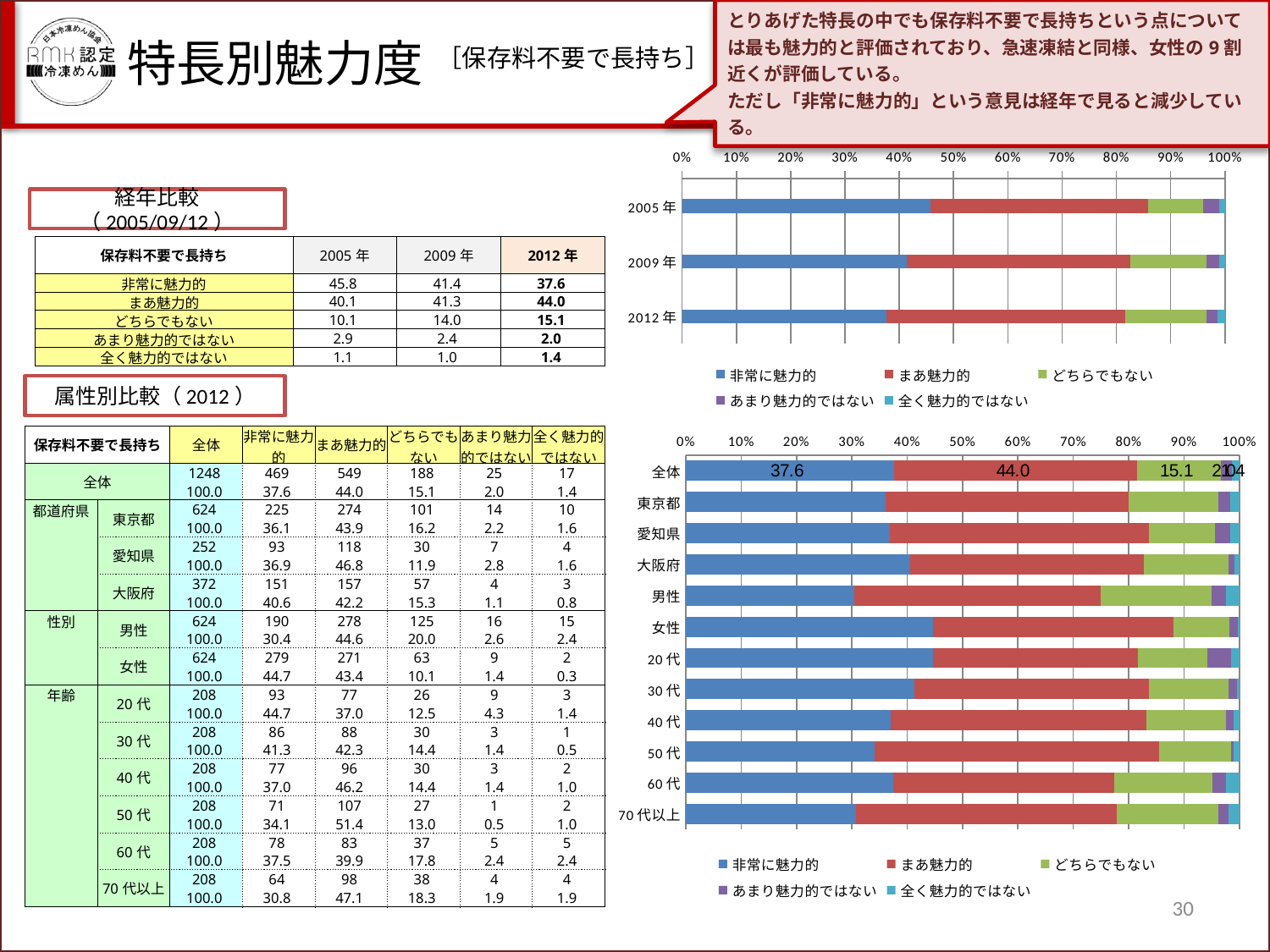
In the top-right chart (経年比較), how many series does the legend list? 5 In the bottom-right chart (属性別比較 2012), what is the まあ魅力的 value labelled on the 全体 bar? 44.0 In the top-right chart (経年比較), is the 非常に魅力的 value for 2005年 greater or less than 40%? greater In the top-right chart (経年比較), is the 非常に魅力的 value for 2012年 greater or less than 40%? less In the bottom-right chart (属性別比較 2012), how many categories are plotted on the vertical axis? 12 In the bottom-right chart (属性別比較 2012), what is the 非常に魅力的 value labelled on the 全体 bar? 37.6 In the bottom-right chart (属性別比較 2012), which has the larger 非常に魅力的 share, 男性 or 女性? 女性 In the top-right chart (経年比較), does the 非常に魅力的 share rise or fall from 2005年 to 2012年? Fall In the bottom-right chart (属性別比較 2012), what is the difference between the まあ魅力的 and 非常に魅力的 values labelled on the 全体 bar? 6.4 In the top-right chart (経年比較), how many years are plotted? 3 What type of chart is the top-right chart comparing 2005年, 2009年 and 2012年? Stacked bar chart In the bottom-right chart (属性別比較 2012), which legend entry is shown in green? どちらでもない